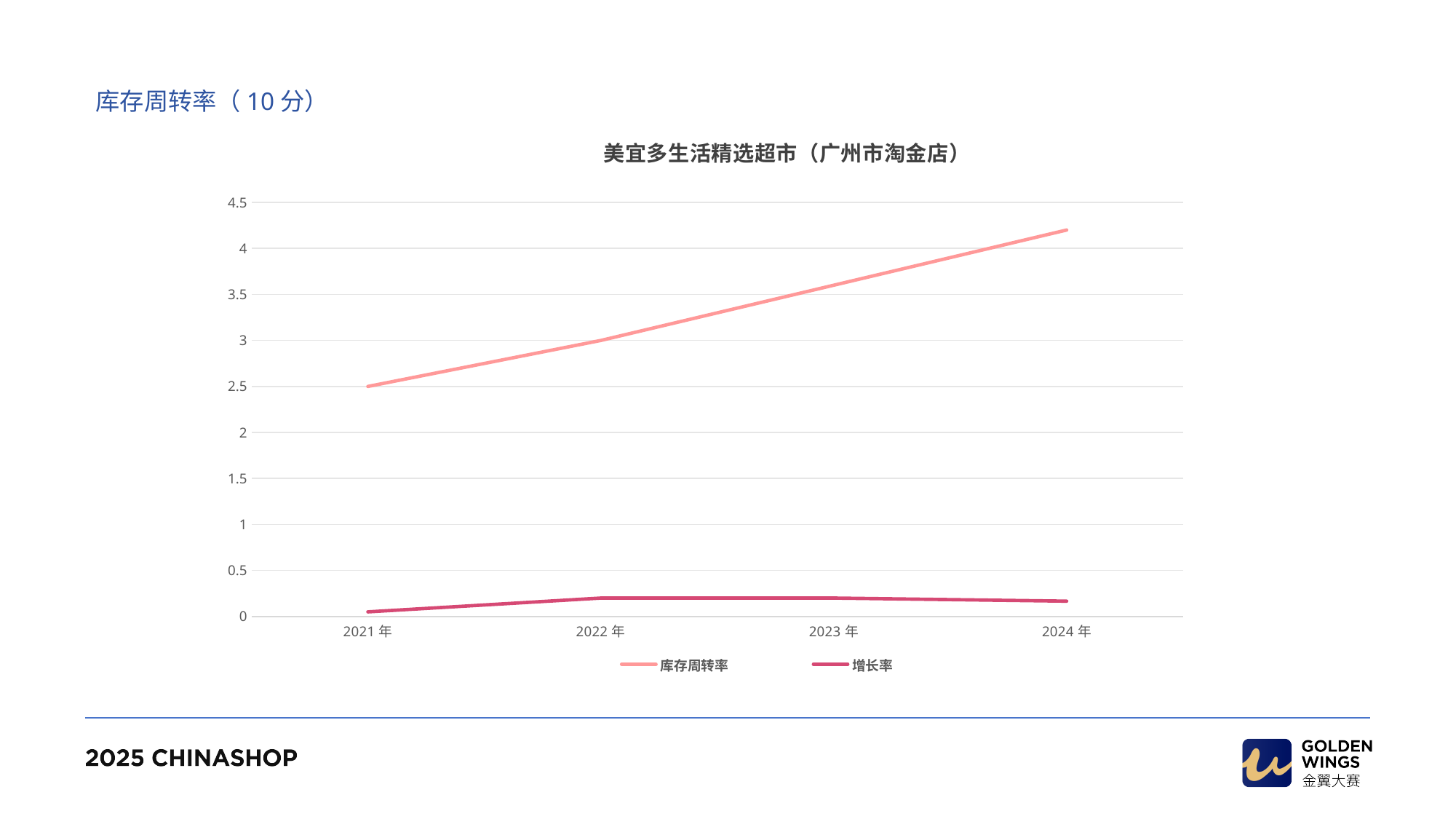
Which two series are listed in the legend? 库存周转率 and 增长率 How many years are shown on the x axis? 4 Is the value of 增长率 for 2022 年 greater or less than 0.5? less Is the value of 库存周转率 for 2023 年 greater or less than 3.5? greater What is the title of the chart? 美宜多生活精选超市（广州市淘金店） Does the 库存周转率 line rise or fall from 2021年 to 2024年? rise In which year is 库存周转率 lowest? 2021 年 How many series does the legend list? 2 Is the value of 库存周转率 for 2024 年 greater or less than 4? greater In which year is 库存周转率 highest? 2024 年 What kind of chart is shown on the slide? line chart Which series has the larger value in 2023 年, 库存周转率 or 增长率? 库存周转率